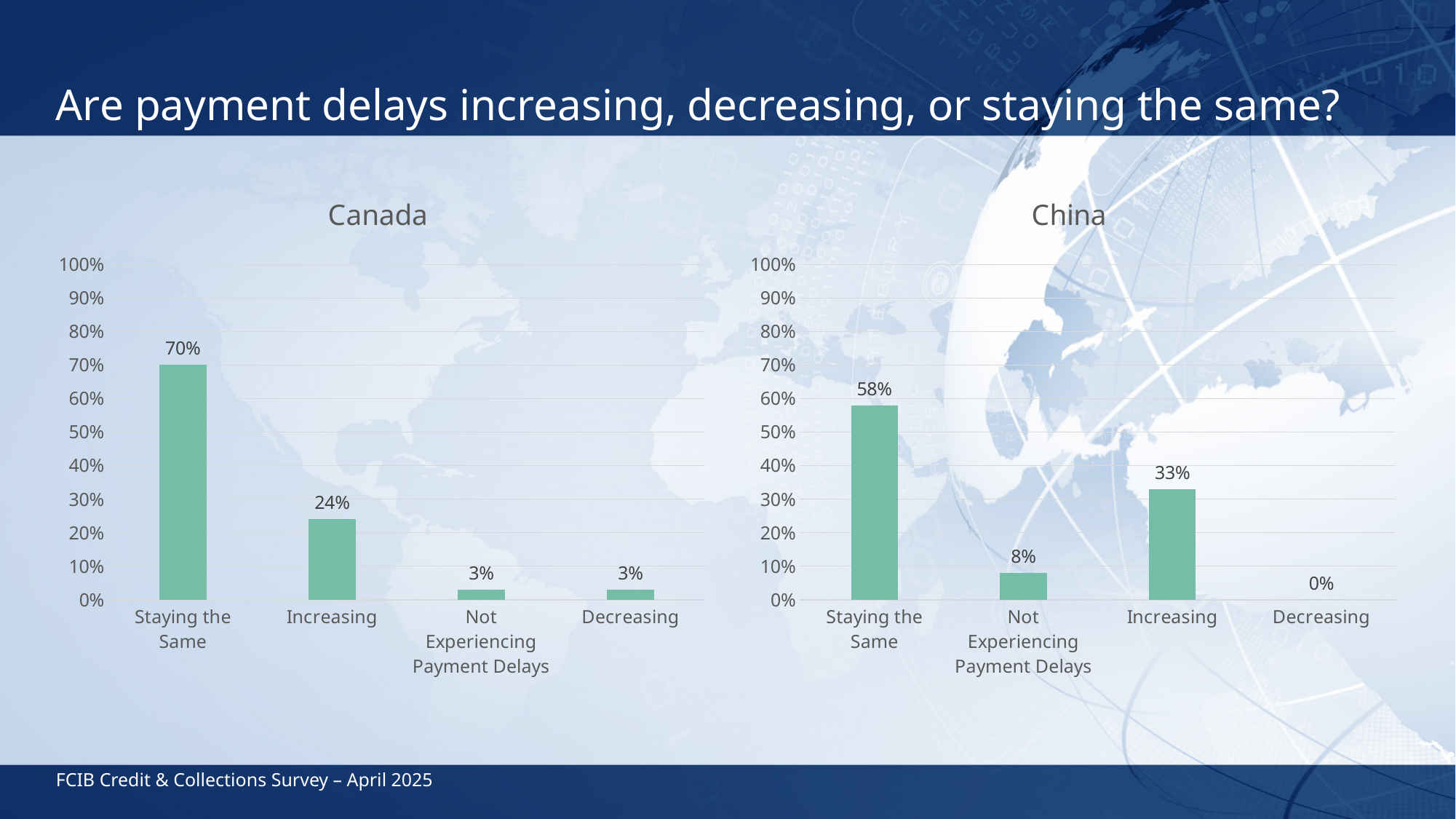
In the China chart, what is the value for Increasing? 33% In the Canada chart, what is the difference between Staying the Same and Increasing? 46% In the China chart, what is the value for Decreasing? 0% What kind of chart is the China chart? Bar chart In the Canada chart, what is the value for Staying the Same? 70% How many categories are shown in the Canada chart? 4 In the Canada chart, is the value for Staying the Same greater or less than 60%? greater In the China chart, which category has the highest value? Staying the Same In the China chart, what is the value for Not Experiencing Payment Delays? 8% In the Canada chart, what is the value for Increasing? 24% In the China chart, which category has the lowest value? Decreasing Which is larger: Staying the Same in the Canada chart or Staying the Same in the China chart? Canada